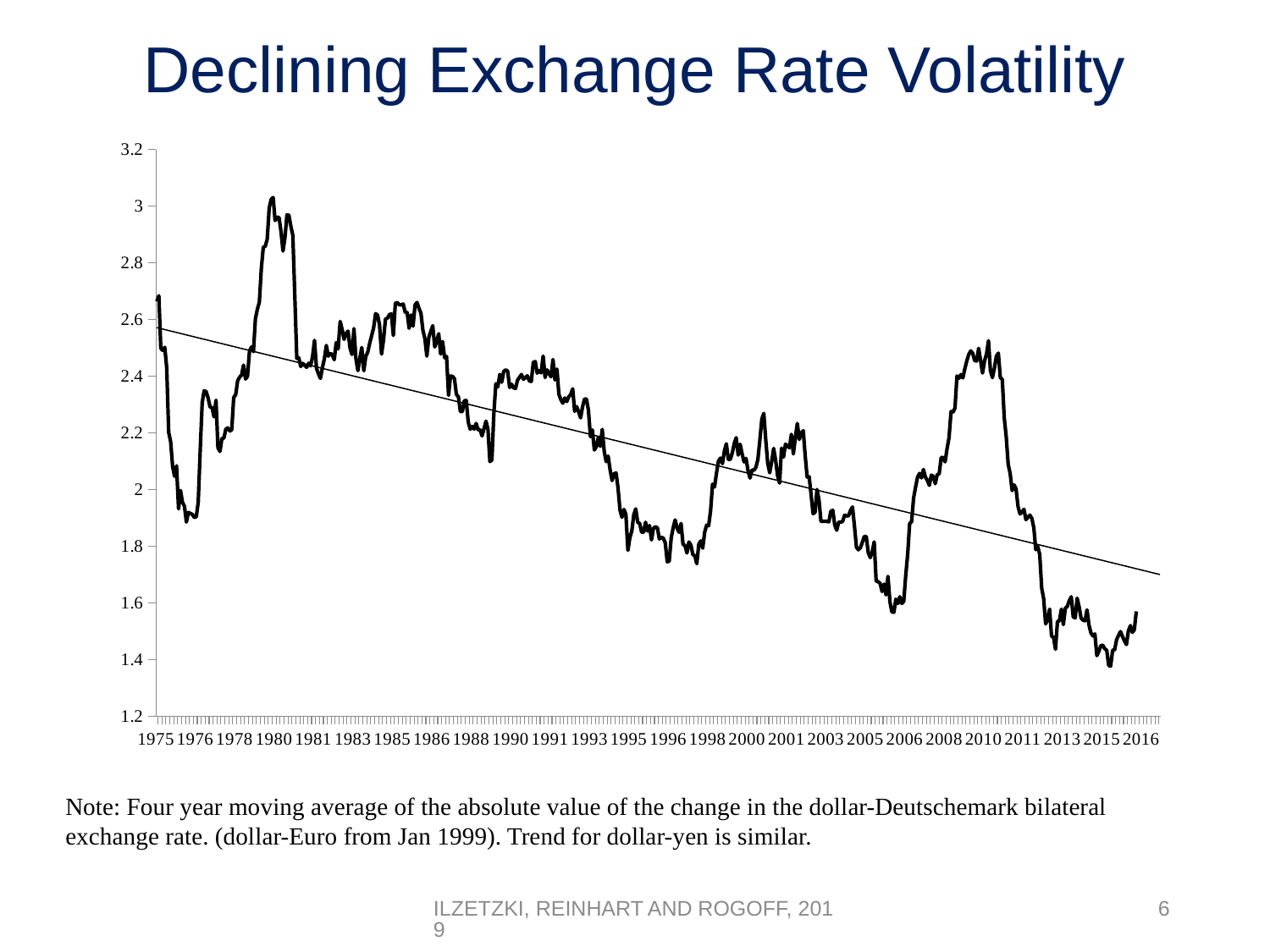
What is the highest value shown on the y axis of the chart? 3.2 Which is larger, the value of the plotted line around 1980 or around 2013? 1980 What kind of chart is shown on the slide? line chart Is the peak value of the plotted line around 1980 greater or less than 2.8? greater Does the trend line on the chart rise or fall from 1975 to 2016? fall Is the value of the plotted line around 2010 greater or less than 2.2? greater What is the title of the chart on the slide? Declining Exchange Rate Volatility Is the value of the plotted line around 2015 greater or less than 1.6? less Around which year labelled on the x axis does the plotted line reach its highest value? 1980 Around which year labelled on the x axis does the plotted line reach its lowest value? 2015